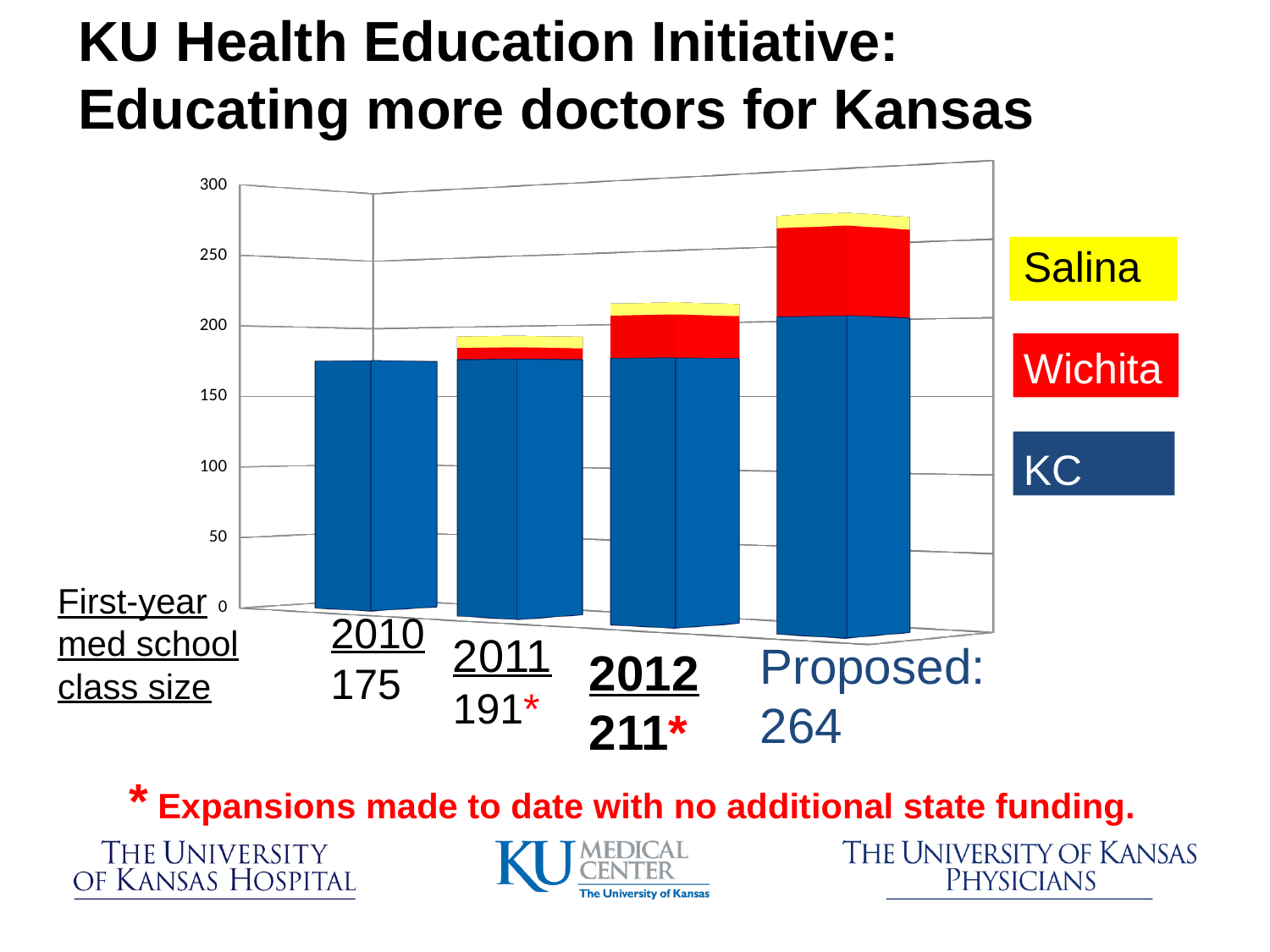
What is the first-year med school class size shown for 2010? 175 What is the first-year med school class size shown for 2011? 191 Which is larger, the class size for 2011 or for 2012? 2012 What is the proposed first-year med school class size? 264 Do the total class sizes rise or fall from 2010 to Proposed? rise How much larger is the proposed class size than the 2012 class size? 53 What is the difference between the 2011 and 2010 class sizes? 16 Is the Wichita value for 2012 greater or less than 50? less How many series does the legend list? 3 Which year has the smallest total class size? 2010 Which category has the largest total class size? Proposed What is the first-year med school class size shown for 2012? 211